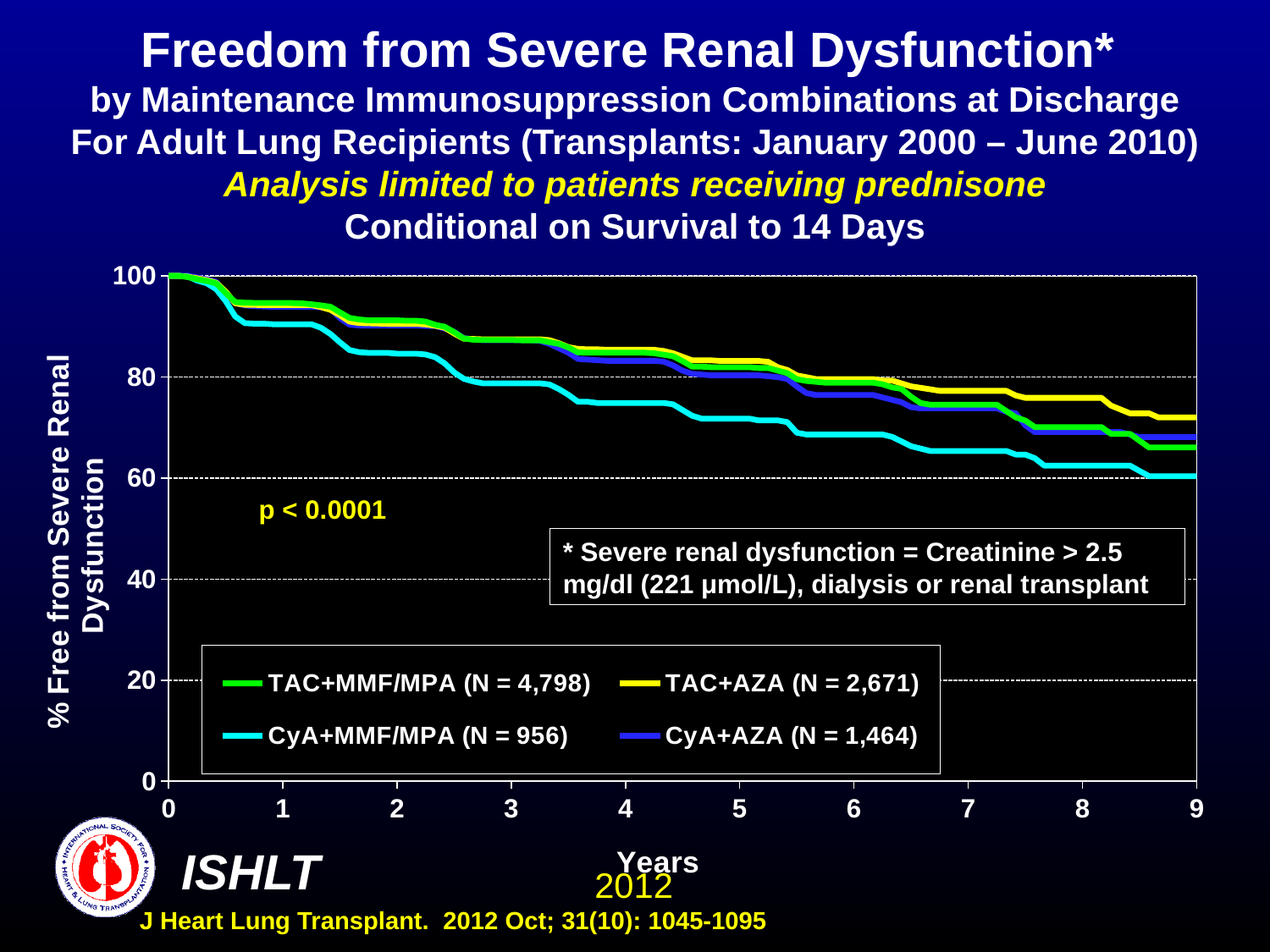
What kind of chart is shown on the slide? line chart Which group has the lowest freedom from severe renal dysfunction at 9 years? CyA+MMF/MPA Do the curves rise or fall as years increase along the x axis? fall Is the value for CyA+MMF/MPA at 4 years greater or less than 80? less What is the N for the TAC+MMF/MPA group shown in the legend? 4,798 What is the N for the CyA+MMF/MPA group shown in the legend? 956 Which group has the highest freedom from severe renal dysfunction at 9 years? TAC+AZA What is the N for the TAC+AZA group shown in the legend? 2,671 At 5 years, which is higher: TAC+AZA or CyA+MMF/MPA? TAC+AZA What is the N for the CyA+AZA group shown in the legend? 1,464 What p-value is printed on the chart? p < 0.0001 How many series does the legend list? 4